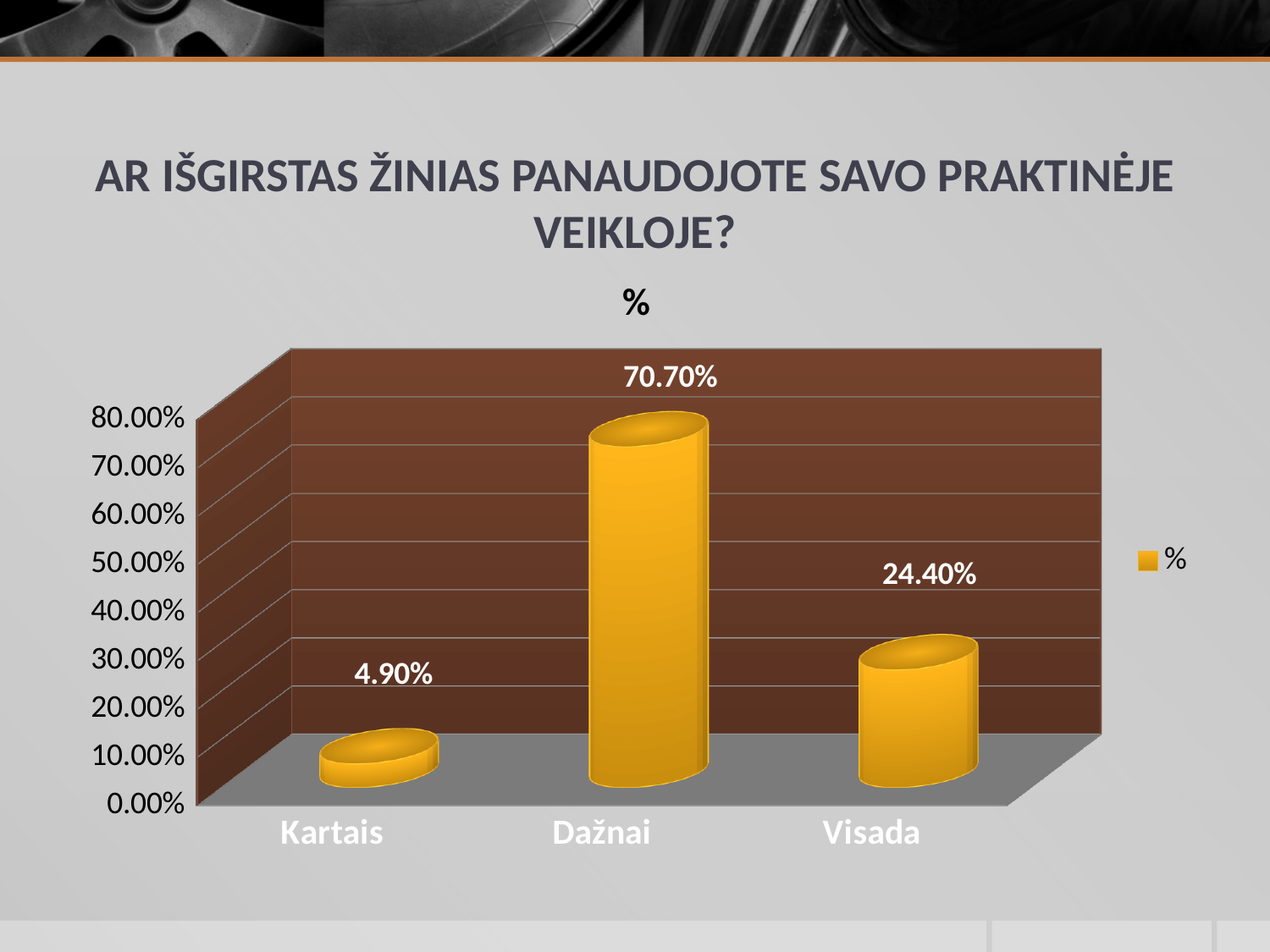
How many categories are shown on the x axis? 3 What kind of chart is shown on the slide? bar chart What is the value for Visada? 24.40% Which category has the lowest value? Kartais What is the difference between the values for Visada and Kartais? 19.50% How many series does the legend list? 1 What is the value for Kartais? 4.90% Which category has the highest value? Dažnai What is the difference between the values for Dažnai and Visada? 46.30% Which is larger, the value for Visada or the value for Kartais? Visada Is the value for Dažnai greater or less than 60.00%? greater What is the value for Dažnai? 70.70%